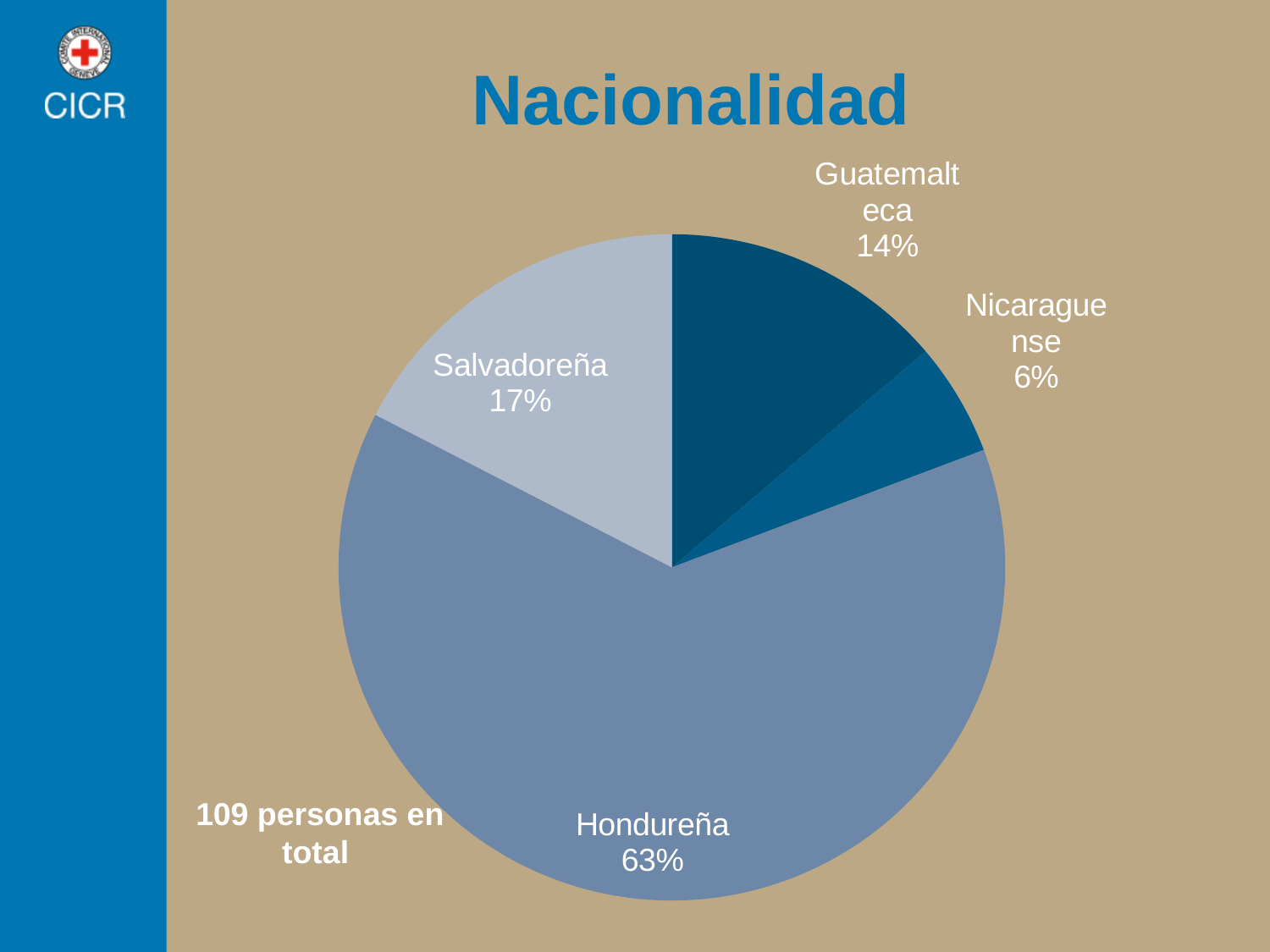
What share of the pie does Guatemalteca represent? 14% Which nationality has the largest slice of the pie? Hondureña Which is larger, the Salvadoreña slice or the Guatemalteca slice? Salvadoreña What share of the pie does Hondureña represent? 63% What share of the pie does Nicaraguense represent? 6% How many people in total does the slide say the chart covers? 109 What is the title of the chart? Nacionalidad What type of chart is shown on the slide? pie chart What is the difference in percentage points between Hondureña and Salvadoreña? 46 How many slices does the pie chart have? 4 Which nationality has the smallest slice of the pie? Nicaraguense